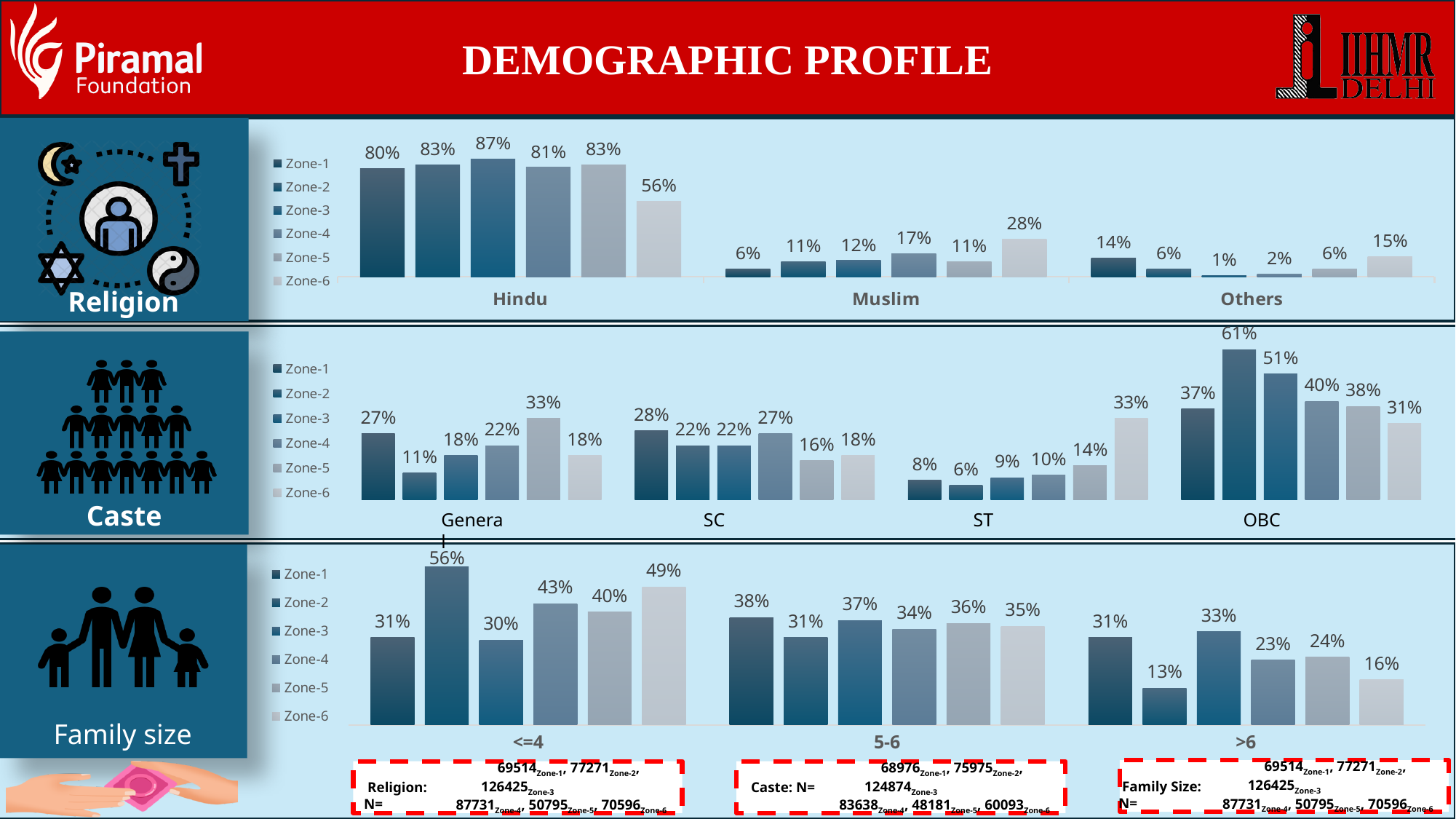
In the Religion chart, which zone has the lowest value in the Others category? Zone-3 In the Caste chart, which is larger in the SC category: Zone-1 or Zone-5? Zone-1 In the Religion chart, which zone has the highest value in the Muslim category? Zone-6 In the Family size chart, what is the difference between Zone-1 and Zone-2 in the 5-6 category? 7% In the Family size chart, what is the value for Zone-2 in the <=4 category? 56% In the Caste chart, what is the value for Zone-2 in the OBC category? 61% In the Religion chart, what is the value for Zone-3 in the Hindu category? 87% In the Religion chart, what is the difference between Zone-3 and Zone-6 in the Hindu category? 31% In the Caste chart, which zone has the highest value in the ST category? Zone-6 How many series does the legend of the Caste chart list? 6 In the Family size chart, which zone has the lowest value in the >6 category? Zone-2 What kind of chart is the Religion chart? Bar chart